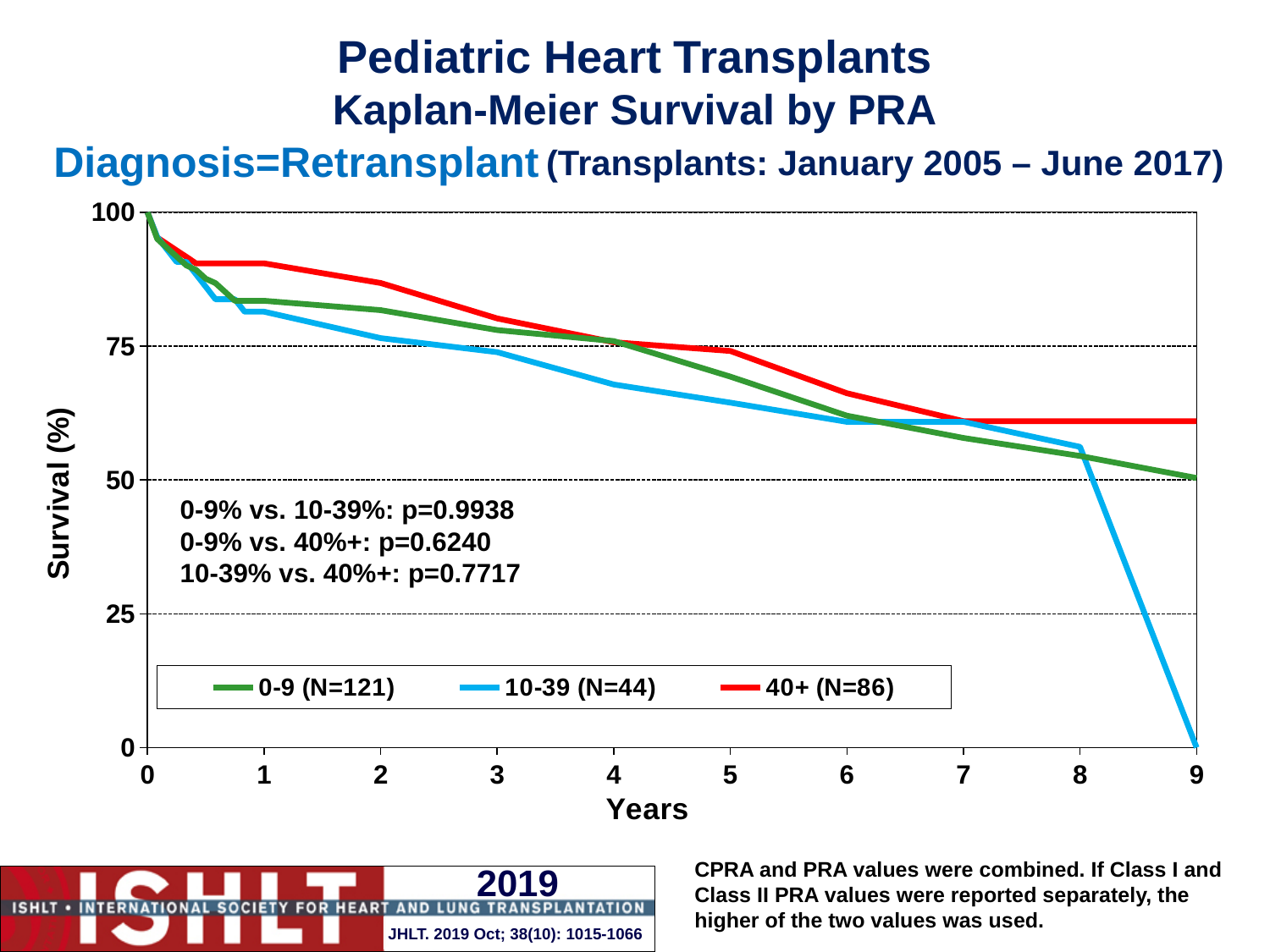
What p-value is given for 0-9% vs. 40%+? p=0.6240 Is the survival value for the 10-39 group at year 5 greater or less than 75? less Do the survival curves rise or fall as years increase? fall What kind of chart is shown on the slide? line chart Which group has the lowest survival at year 9? 10-39 (N=44) What is the N for the 0-9 group shown in the legend? 121 Is the survival value for the 40+ group at year 9 greater or less than 50? greater How many series does the legend list? 3 What p-value is given for 10-39% vs. 40%+? p=0.7717 Is the survival value for the 0-9 group at year 2 greater or less than 75? greater What is the N for the 10-39 group shown in the legend? 44 Which group has the highest survival at year 9? 40+ (N=86)